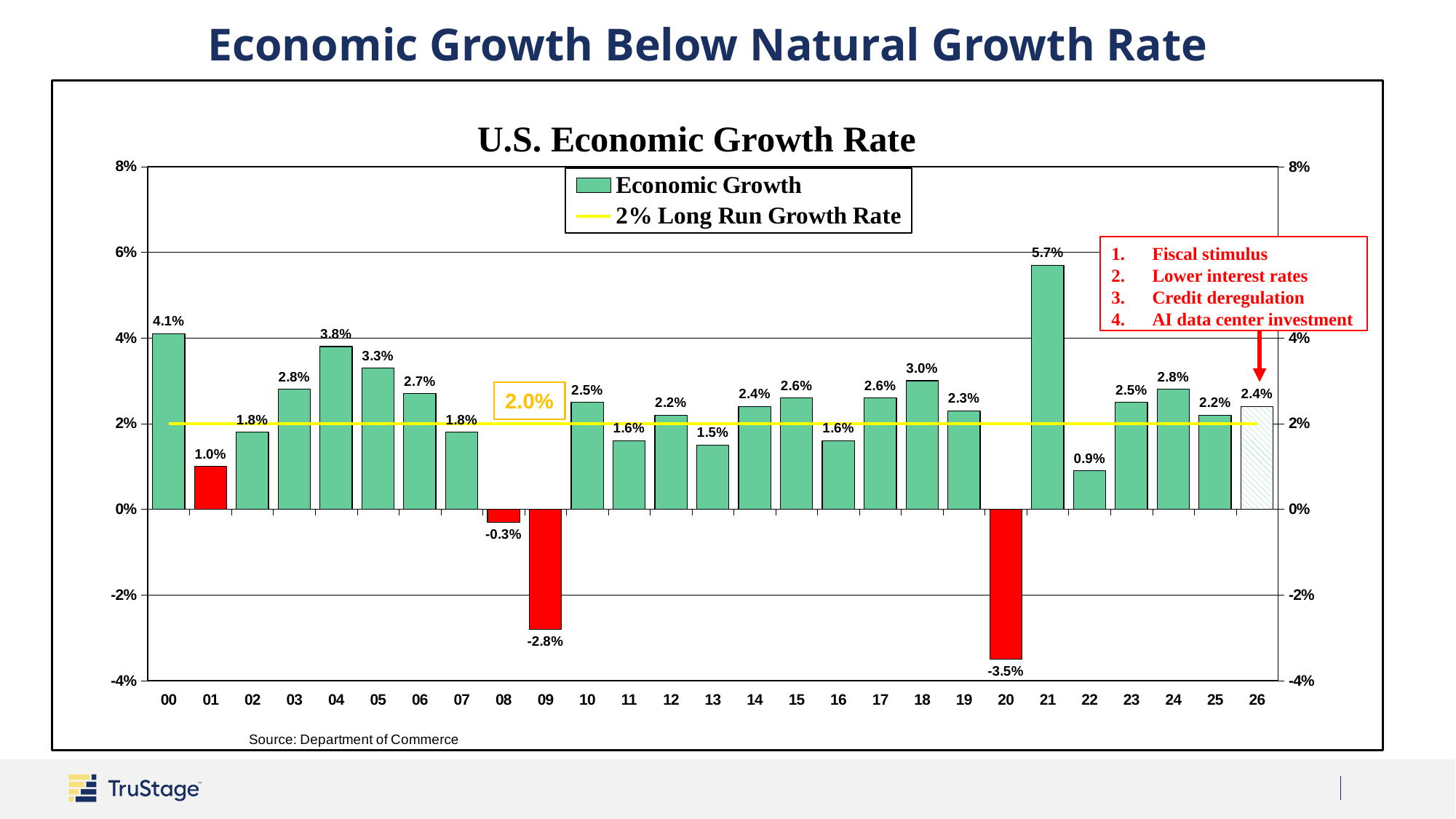
Which year had a higher economic growth rate, 2004 or 2005? 04 Which year has the lowest economic growth rate on the chart? 20 How many years are shown on the x axis of the chart? 27 What kind of chart is used to show the economic growth rate? bar chart What is the economic growth rate shown for 2009? -2.8% What is the economic growth rate shown for 2026? 2.4% What is the U.S. economic growth rate shown for 2021? 5.7% Is the economic growth rate for 2013 greater or less than 2%? less What is the title of the chart? U.S. Economic Growth Rate Which year has the highest economic growth rate on the chart? 21 What is the difference between the economic growth rate in 2021 and in 2022? 4.8% How many series does the legend list? 2